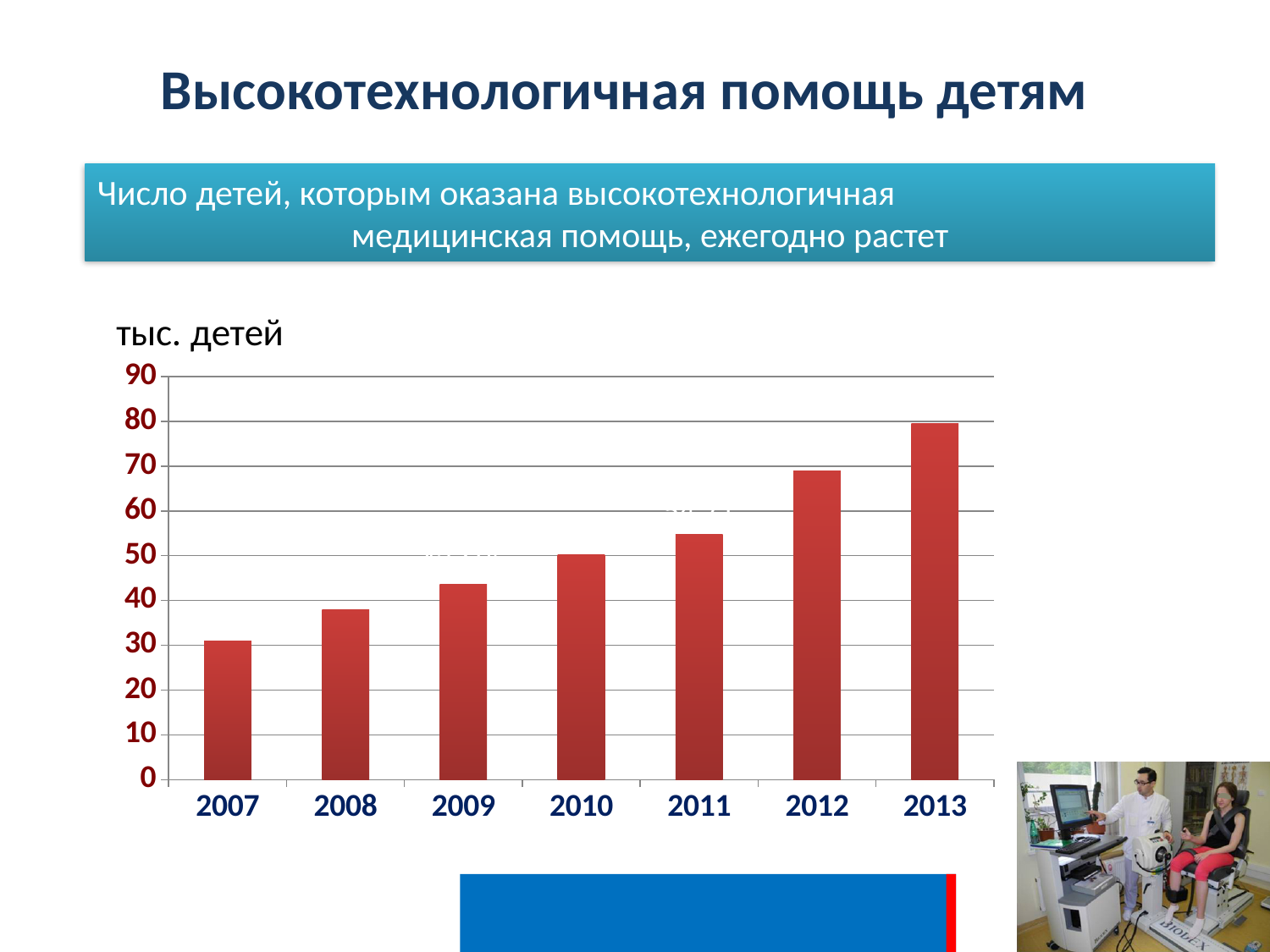
Do the values rise or fall from 2007 to 2013? rise Is the value for 2012 greater or less than 60? greater Which year has the lowest bar in the chart? 2007 Is the value for 2009 greater or less than 50? less What kind of chart is shown on the slide? bar chart Which year has the highest bar in the chart? 2013 Which year has the larger value, 2009 or 2012? 2012 How many years are shown on the x axis of the chart? 7 Is the value for 2013 greater or less than 70? greater What unit label is shown above the vertical axis of the chart? тыс. детей